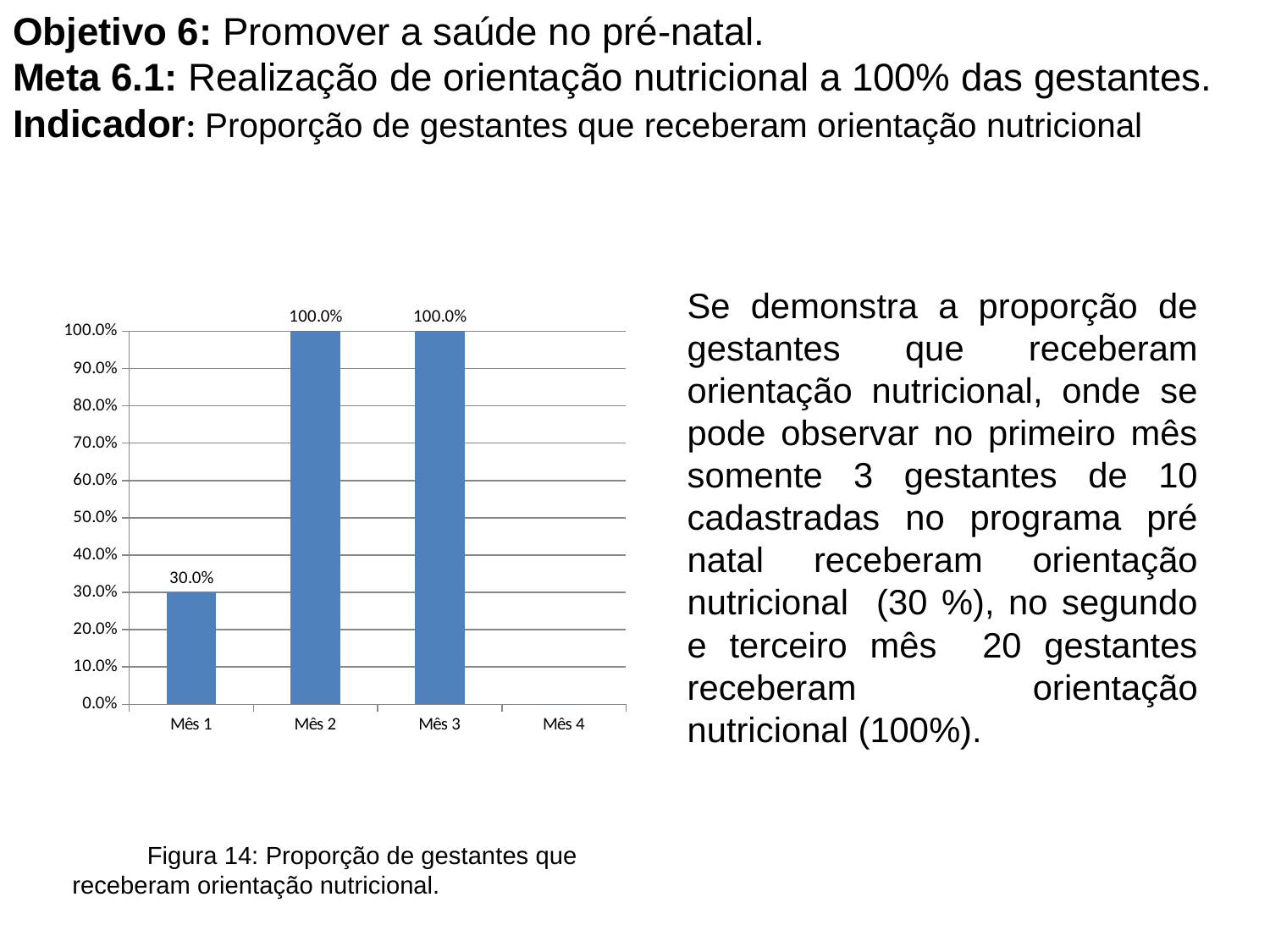
What is the figure caption below the chart? Figura 14: Proporção de gestantes que receberam orientação nutricional. What is the value for Mês 3? 100.0% Which is larger, the value for Mês 1 or the value for Mês 3? Mês 3 What is the value for Mês 2? 100.0% What is the difference between the values for Mês 2 and Mês 1? 70.0% Is the value for Mês 1 greater or less than 50.0%? less How many month categories are shown on the x axis? 4 What kind of chart is shown on the slide? bar chart Which month has the lowest value among the months with a bar? Mês 1 Do the values rise or fall from Mês 1 to Mês 2? rise What is the value for Mês 1? 30.0% Which category on the x axis has no bar plotted? Mês 4